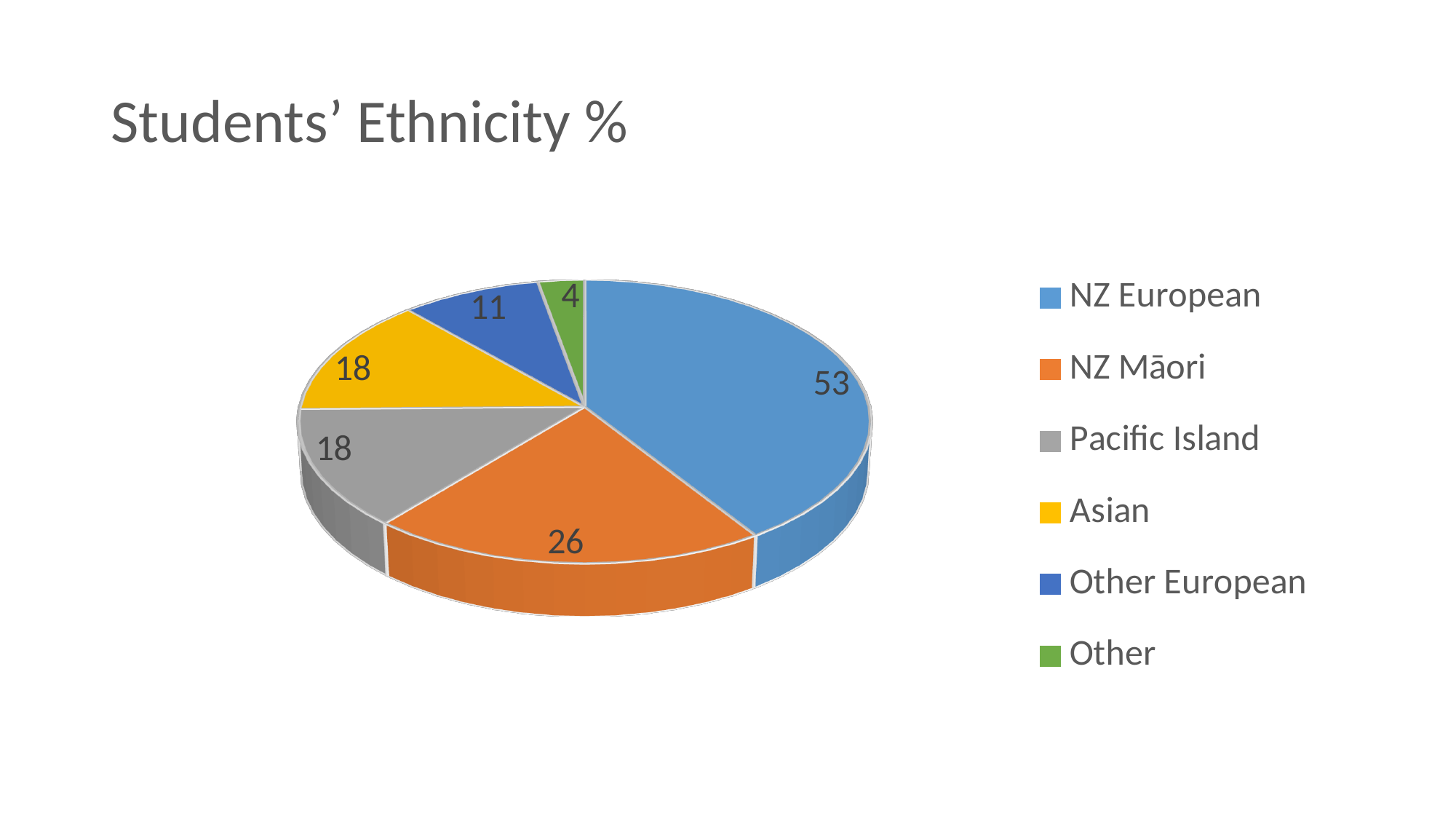
Which category has the largest slice of the pie? NZ European What is the title of the chart? Students' Ethnicity % What type of chart is shown on the slide? pie chart What is the value shown for NZ European? 53 Which category has the smallest slice of the pie? Other How many categories does the legend list? 6 Which is larger, the value for Pacific Island or the value for Other European? Pacific Island What is the value shown for Asian? 18 What is the value shown for Other European? 11 What is the value shown for Other? 4 What is the difference between the values for NZ European and NZ Māori? 27 What is the value shown for NZ Māori? 26